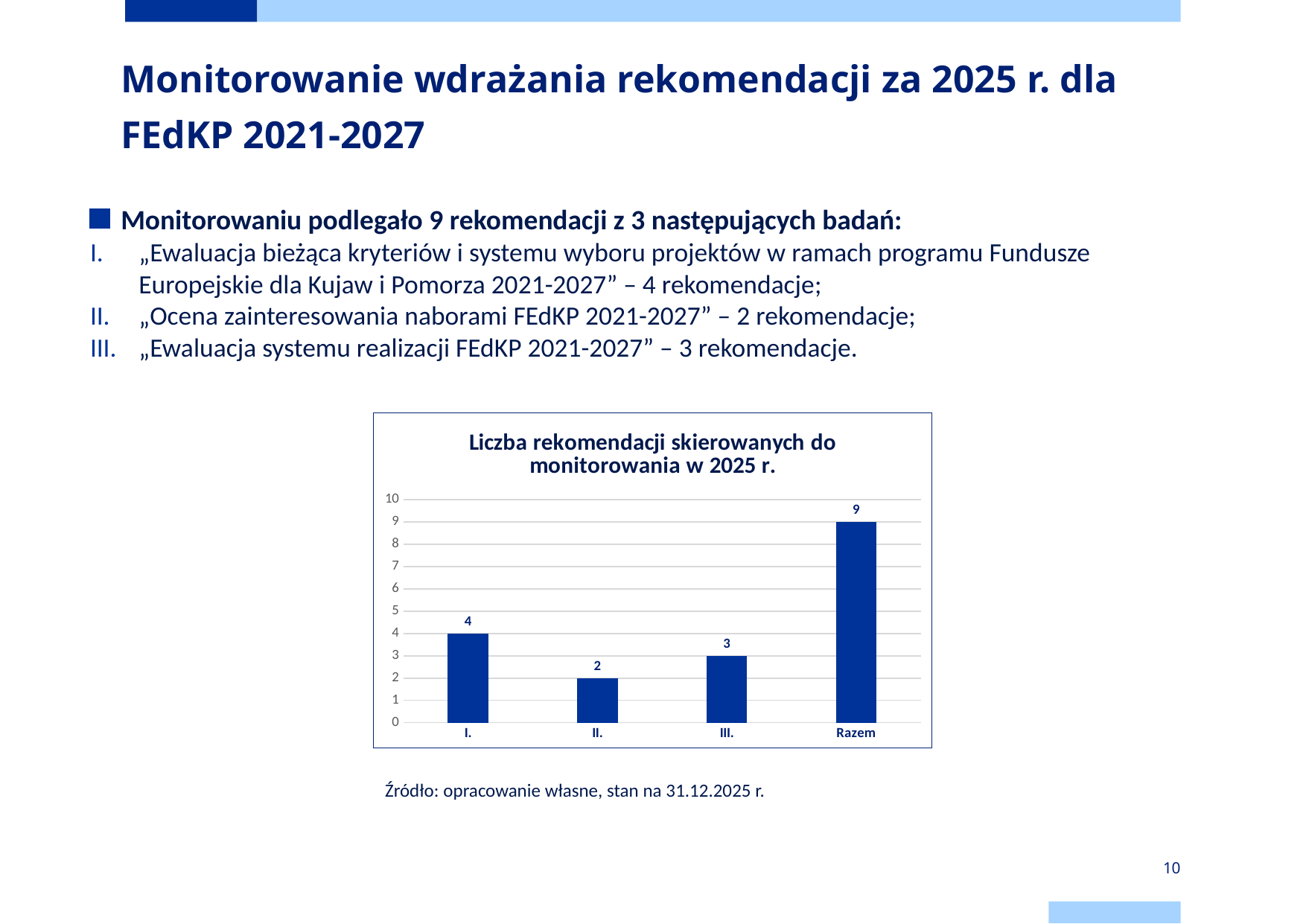
Which category has the highest bar in the chart? Razem What is the title of the chart? Liczba rekomendacji skierowanych do monitorowania w 2025 r. What is the value for category I. in the chart? 4 What is the value for category II. in the chart? 2 Which is larger, the value for I. or the value for III.? I. Is the value for Razem greater or less than 5? greater What kind of chart is shown on the slide? Bar chart What is the value for category III. in the chart? 3 Which category has the lowest bar in the chart? II. How many bars are shown in the chart? 4 What is the value for the Razem bar in the chart? 9 What is the difference between the values for I. and II.? 2